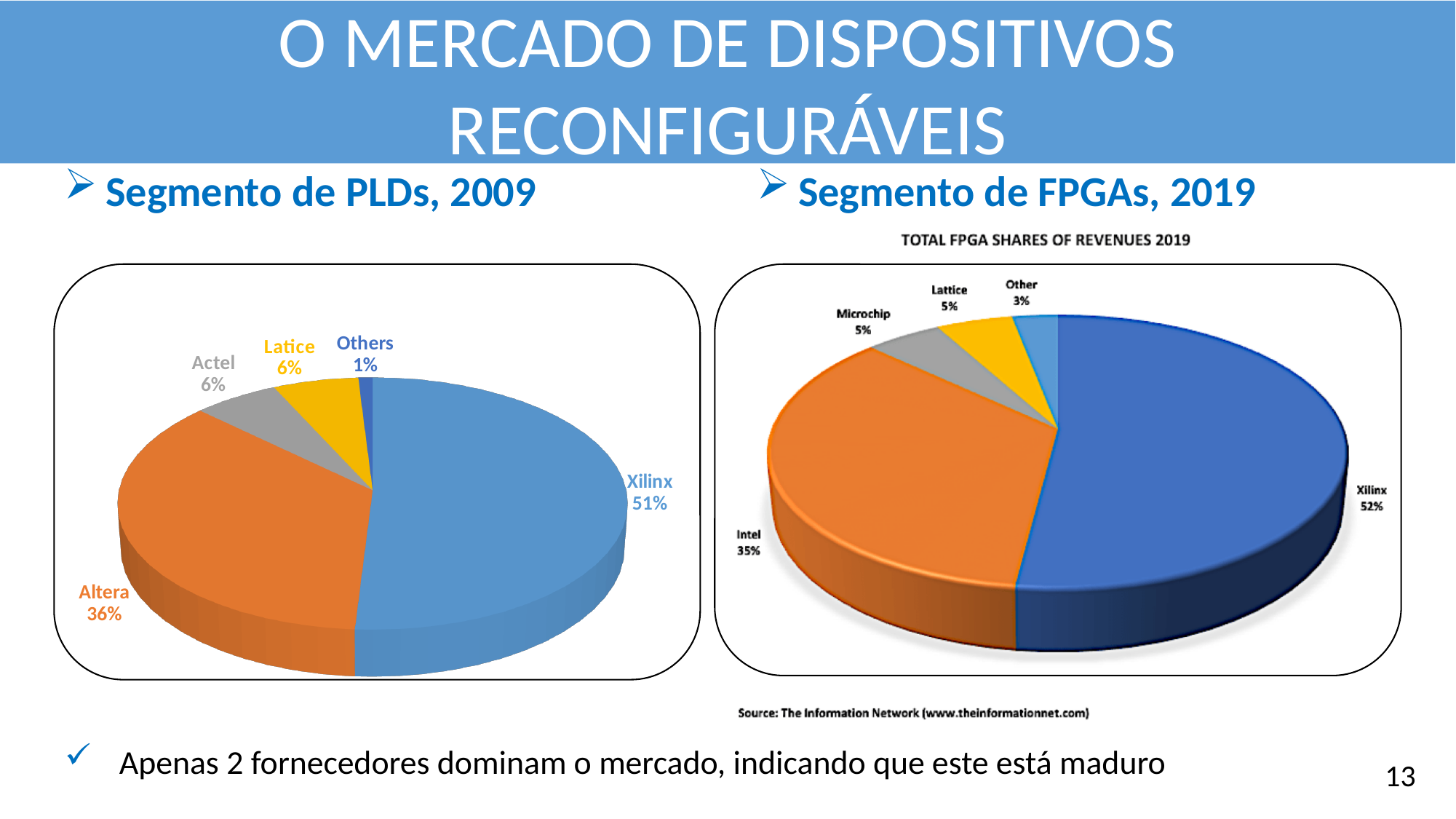
What type of chart is used for 'TOTAL FPGA SHARES OF REVENUES 2019' on the right? Pie chart In the 'Segmento de PLDs, 2009' pie chart on the left, what share does Xilinx hold? 51% In the 'Segmento de PLDs, 2009' pie chart on the left, which company has the largest slice? Xilinx In the 'Segmento de PLDs, 2009' pie chart on the left, what share does Altera hold? 36% In the 'TOTAL FPGA SHARES OF REVENUES 2019' pie chart on the right, what share does Intel hold? 35% In the 'TOTAL FPGA SHARES OF REVENUES 2019' pie chart on the right, which is larger, the Intel share or the Other share? Intel How many slices does the 'Segmento de PLDs, 2009' pie chart on the left have? 5 In the 'TOTAL FPGA SHARES OF REVENUES 2019' pie chart on the right, what share does Microchip hold? 5% In the 'TOTAL FPGA SHARES OF REVENUES 2019' pie chart on the right, what is the difference between the Xilinx and Intel shares? 17% In the 'Segmento de PLDs, 2009' pie chart on the left, what is the difference between the Xilinx and Altera shares? 15% In the 'TOTAL FPGA SHARES OF REVENUES 2019' pie chart on the right, which company has the largest share? Xilinx In the 'Segmento de PLDs, 2009' pie chart on the left, which category has the smallest slice? Others